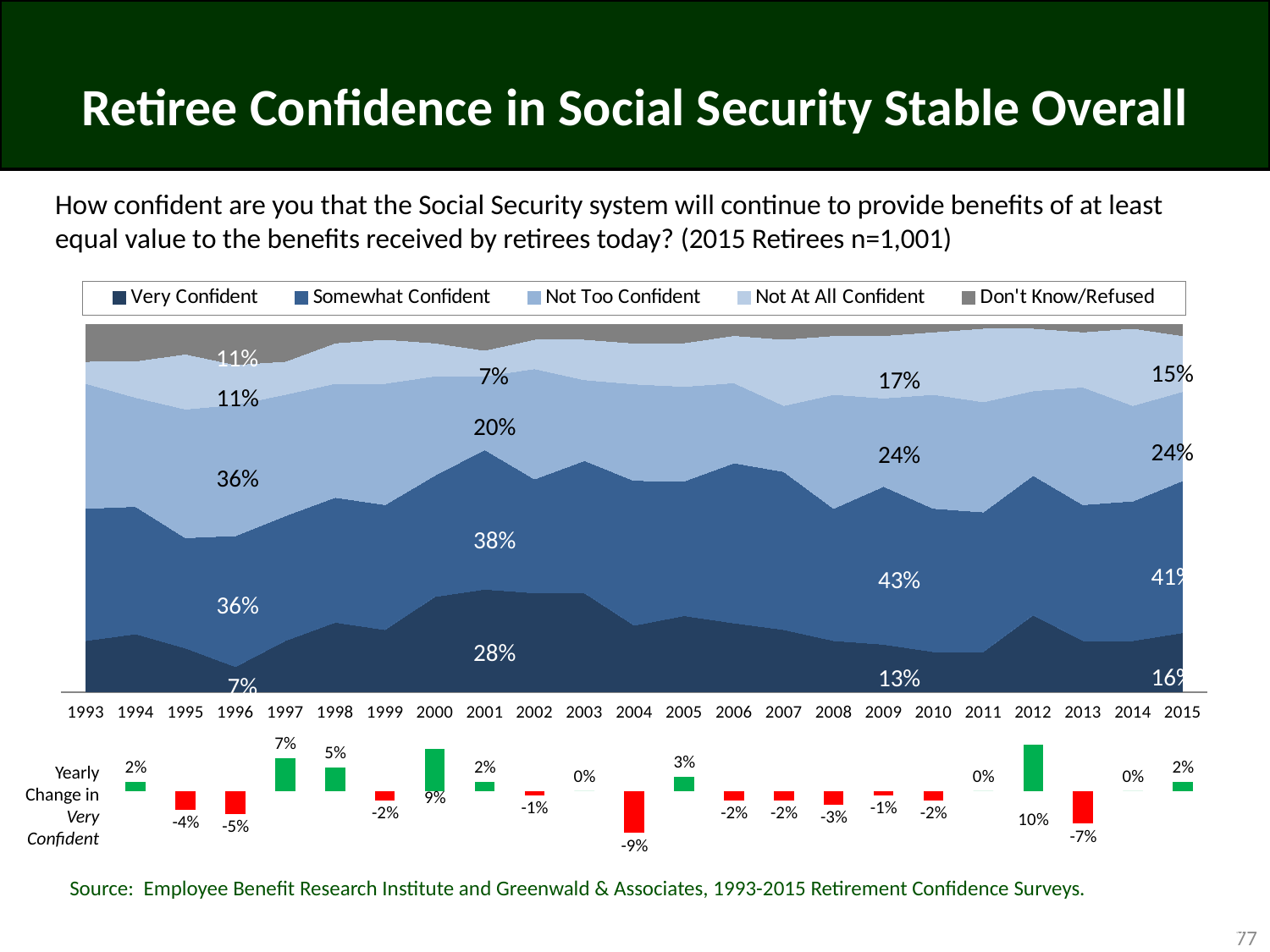
How many years are shown on the x axis of the stacked area chart? 23 In the Yearly Change in Very Confident bar chart, which year has the largest increase? 2012 In the Yearly Change in Very Confident bar chart, what is the value for 2013? -7% In the stacked area chart, what percentage of retirees were Somewhat Confident in 2009? 43% In the stacked area chart, what percentage of retirees were Not Too Confident in 2001? 20% In the stacked area chart, which is larger: the Very Confident share in 2001 or in 2009? 2001 In the Yearly Change in Very Confident bar chart, which year has the largest decrease? 2004 In the stacked area chart, what is the difference between the Somewhat Confident share in 2009 and in 2015? 2% In the stacked area chart, what percentage of retirees were Very Confident in 1996? 7% What kind of chart is the Yearly Change in Very Confident chart at the bottom of the slide? Bar chart In the stacked area chart, what percentage of retirees were Very Confident in 2015? 16% How many series does the legend of the stacked area chart list? 5